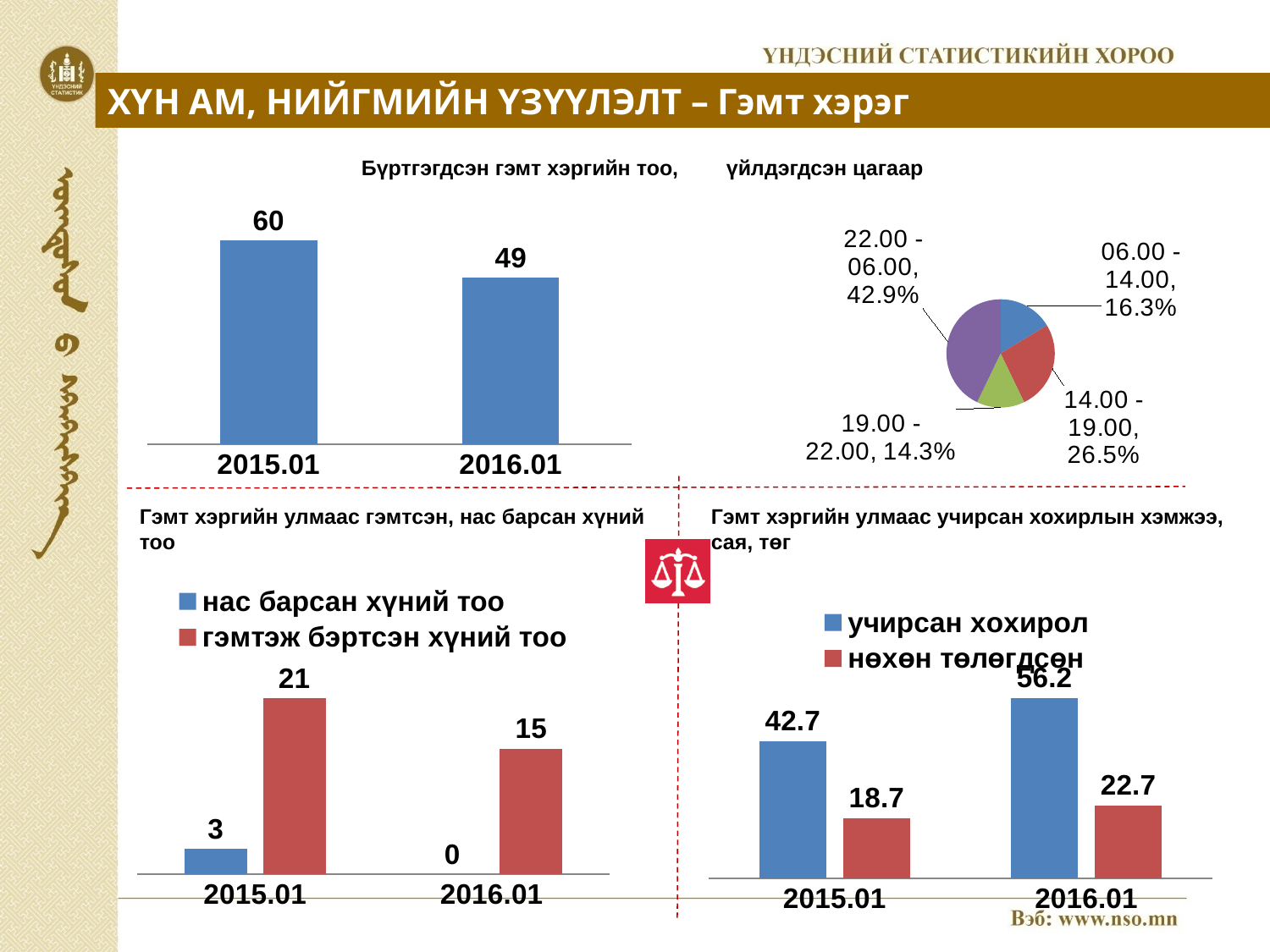
What kind of chart is the top-right chart (үйлдэгдсэн цагаар)? Pie chart In the bottom-left chart (Гэмт хэргийн улмаас гэмтсэн, нас барсан хүний тоо), what is the value of гэмтэж бэртсэн хүний тоо for 2015.01? 21 In the bottom-left chart (Гэмт хэргийн улмаас гэмтсэн, нас барсан хүний тоо), how many series does the legend list? 2 In the bottom-left chart (Гэмт хэргийн улмаас гэмтсэн, нас барсан хүний тоо), what is the value of нас барсан хүний тоо for 2016.01? 0 In the top-right pie chart (үйлдэгдсэн цагаар), how many slices are there? 4 In the top-left chart (Бүртгэгдсэн гэмт хэргийн тоо), what is the value for 2016.01? 49 In the top-right pie chart (үйлдэгдсэн цагаар), what share does the 22.00 - 06.00 slice have? 42.9% In the bottom-right chart (Гэмт хэргийн улмаас учирсан хохирлын хэмжээ, сая, төг), what is the difference between учирсан хохирол and нөхөн төлөгдсөн for 2015.01? 24.0 In the bottom-right chart (Гэмт хэргийн улмаас учирсан хохирлын хэмжээ, сая, төг), what is the value of учирсан хохирол for 2016.01? 56.2 In the top-right pie chart (үйлдэгдсэн цагаар), which time period has the smallest share? 19.00 - 22.00 In the top-left chart (Бүртгэгдсэн гэмт хэргийн тоо), what is the value for 2015.01? 60 In the top-left chart (Бүртгэгдсэн гэмт хэргийн тоо), what is the difference between the 2015.01 and 2016.01 values? 11